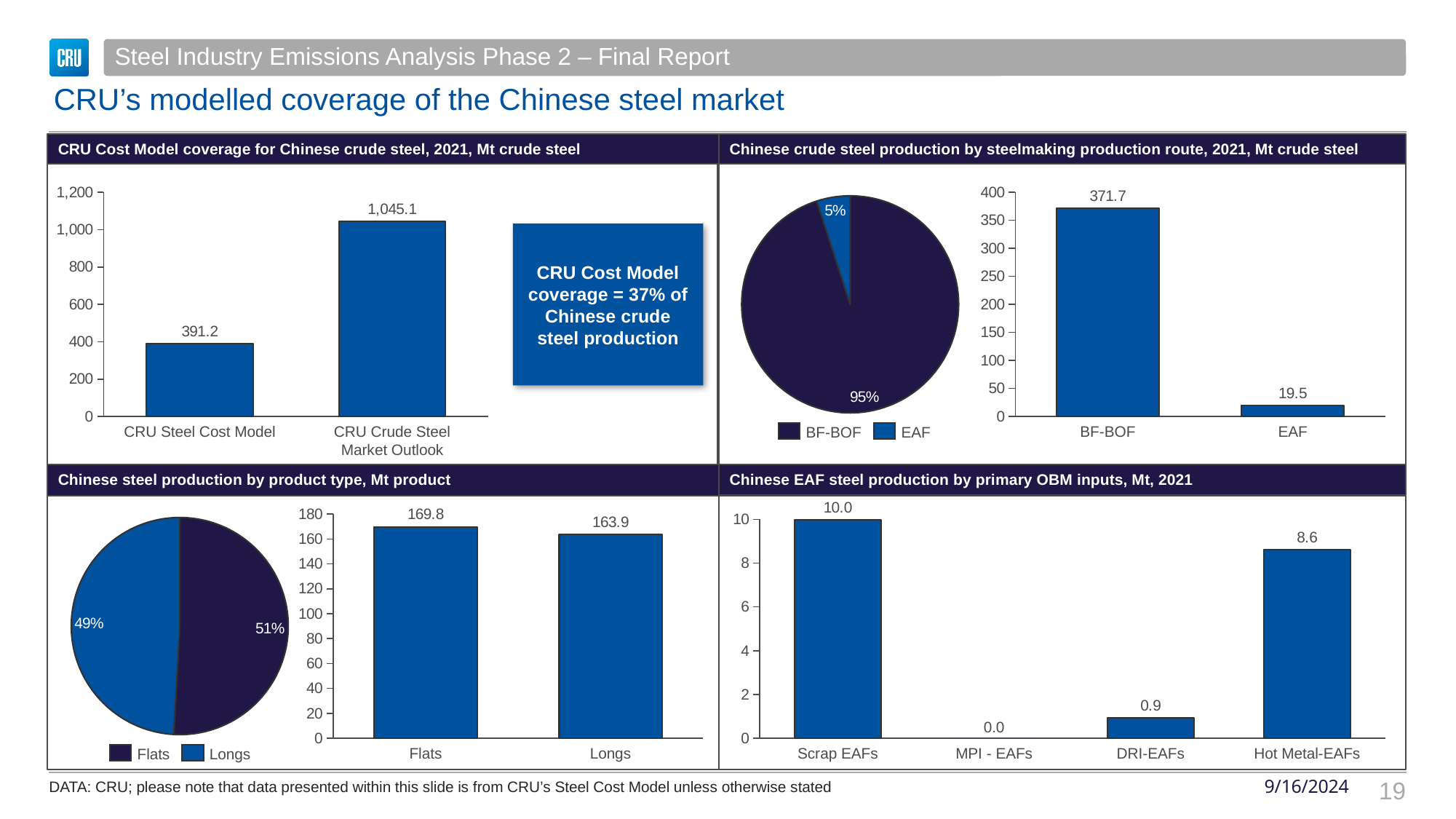
In the 'Chinese steel production by product type' pie chart, what share do Longs have? 49% In the 'Chinese EAF steel production by primary OBM inputs, Mt, 2021' chart, what is the value for DRI-EAFs? 0.9 In the 'Chinese EAF steel production by primary OBM inputs, Mt, 2021' chart, which category has the highest value? Scrap EAFs In the 'CRU Cost Model coverage for Chinese crude steel, 2021' chart, what is the value for CRU Steel Cost Model? 391.2 In the 'Chinese steel production by product type' bar chart, what is the value for Longs? 163.9 In the 'Chinese crude steel production by steelmaking production route, 2021' bar chart, what is the difference between BF-BOF and EAF? 352.2 In the 'CRU Cost Model coverage for Chinese crude steel, 2021' chart, what is the difference between the CRU Crude Steel Market Outlook and CRU Steel Cost Model values? 653.9 In the 'Chinese crude steel production by steelmaking production route, 2021' pie chart, what share does EAF have? 5% In the 'CRU Cost Model coverage for Chinese crude steel, 2021' chart, what is the value for CRU Crude Steel Market Outlook? 1,045.1 In the 'Chinese crude steel production by steelmaking production route, 2021' bar chart, what is the value for BF-BOF? 371.7 In the 'Chinese steel production by product type' bar chart, which category is higher, Flats or Longs? Flats In the 'Chinese EAF steel production by primary OBM inputs, Mt, 2021' chart, how many categories are shown on the x axis? 4